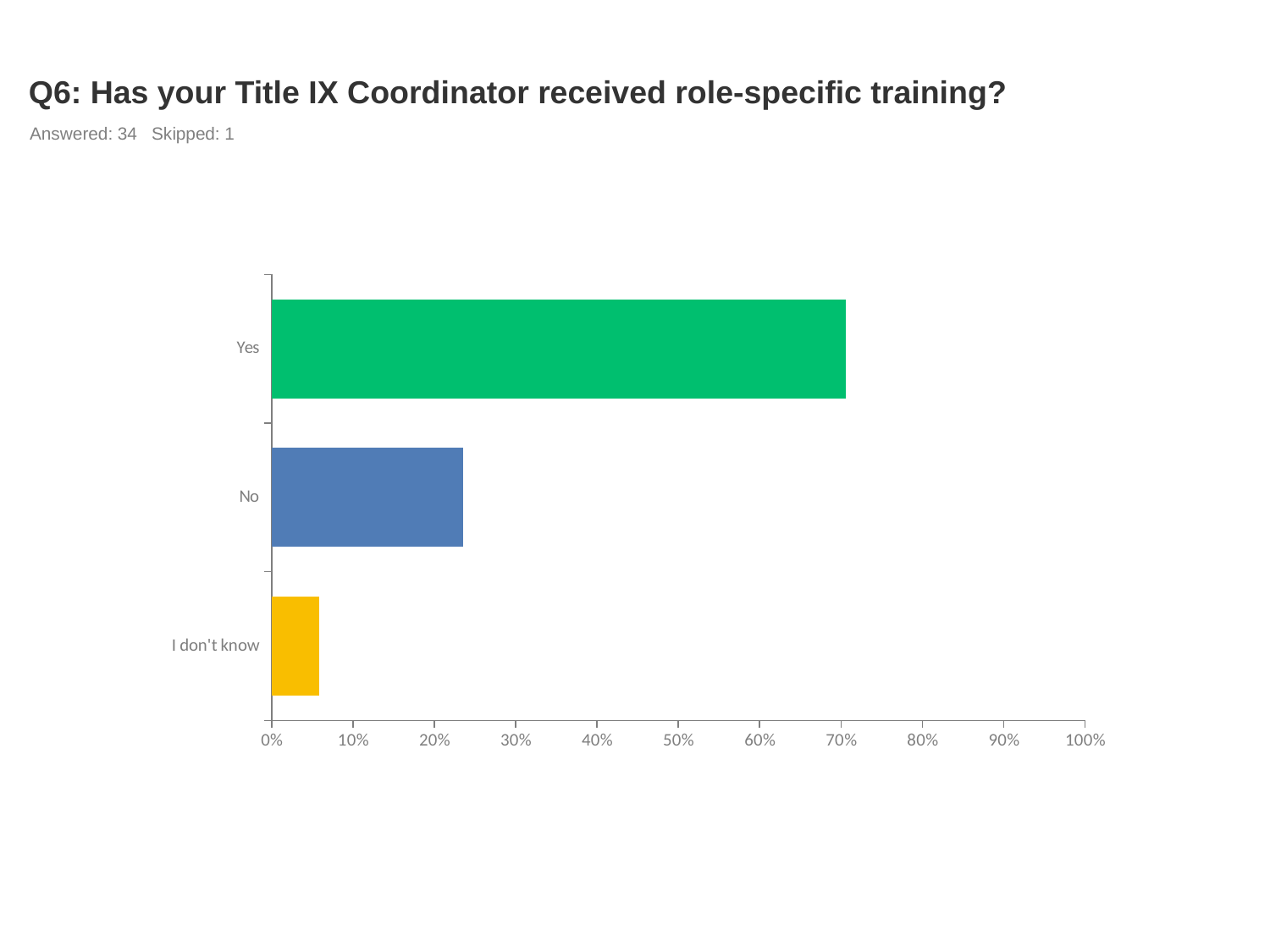
Which category has the lowest value? I don't know Is the value for I don't know greater or less than 10%? less Is the value for No greater or less than 30%? less Which category has the highest value? Yes Which is larger, the value for Yes or the value for No? Yes Is the value for Yes greater or less than 60%? greater Which is larger, the value for No or the value for I don't know? No What colour is the bar for Yes? green What is the title of the chart? Q6: Has your Title IX Coordinator received role-specific training? What kind of chart is shown on the slide? bar chart How many categories are plotted in the chart? 3